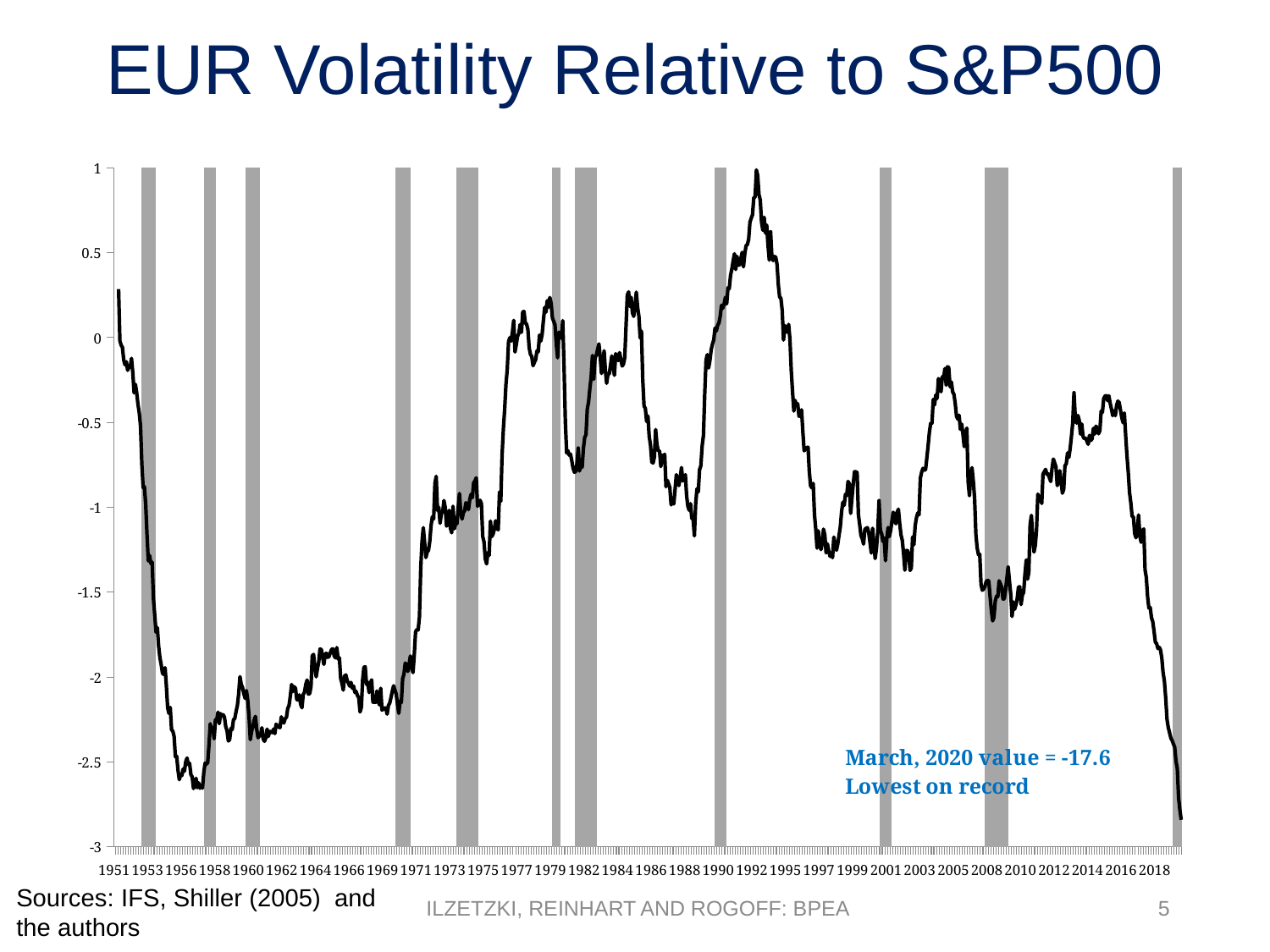
Is the value around 1956 greater or less than -2? less Is the value around 1964 greater or less than -1.5? less Does the line rise or fall between 1969 and 1977? rise According to the annotation on the chart, what is the March 2020 value? -17.6 Around which year does the line reach its highest point on the chart? 1993 What kind of chart is shown on the slide? line chart What is the lowest value shown on the y axis? -3 What is the title of the chart? EUR Volatility Relative to S&P500 Is the value around 2005 greater or less than -0.5? greater Does the line rise or fall between 1951 and 1956? fall